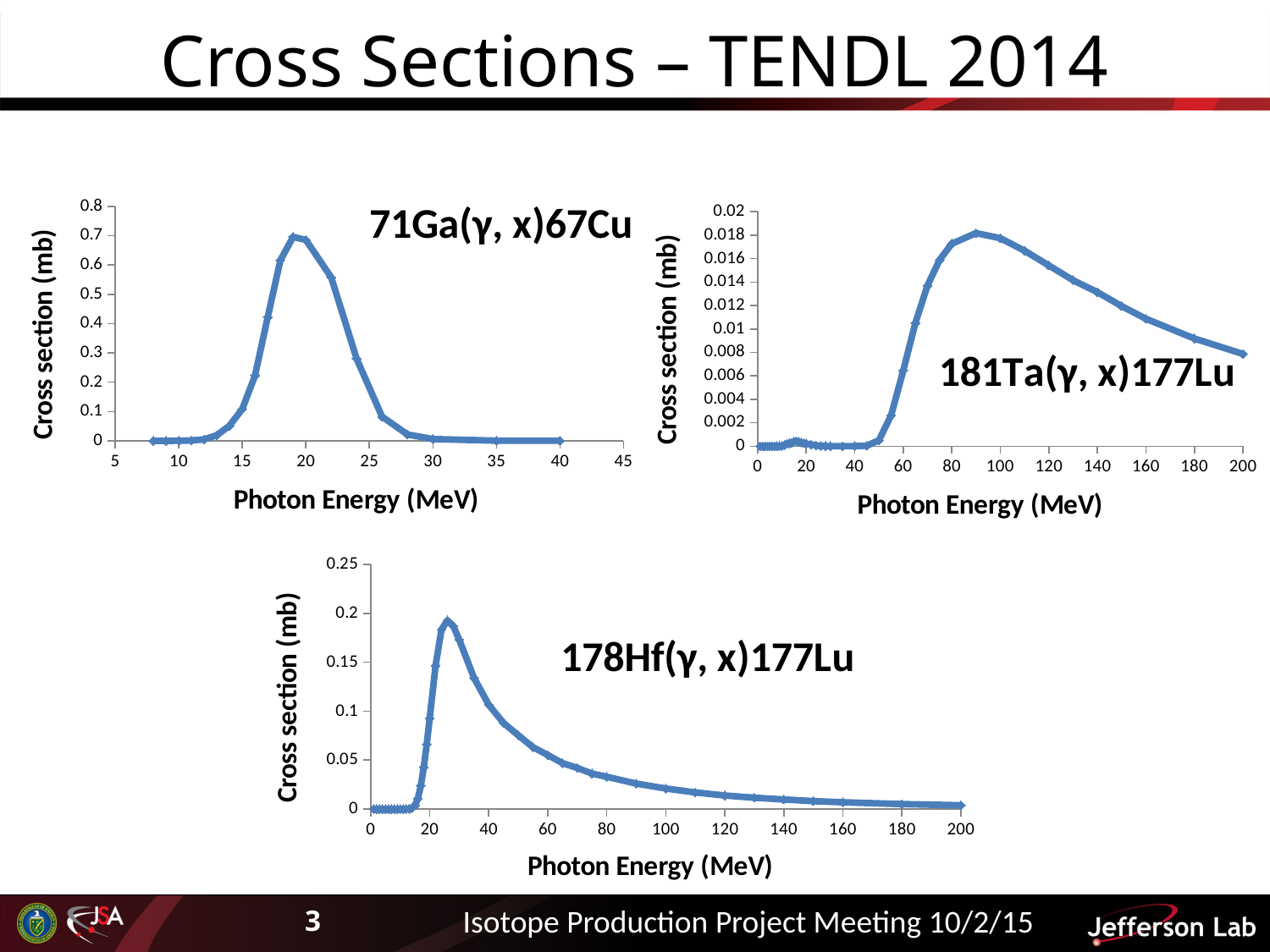
What is the y-axis label of the 181Ta(γ, x)177Lu chart? Cross section (mb) In the 71Ga(γ, x)67Cu chart, is the peak cross section greater or less than 0.6? greater In the 178Hf(γ, x)177Lu chart, does the cross section rise or fall between 40 MeV and 200 MeV? fall In the 181Ta(γ, x)177Lu chart, is the cross section at 200 MeV greater or less than 0.01? less In the 178Hf(γ, x)177Lu chart, is the cross section at 100 MeV greater or less than 0.05? less In the 181Ta(γ, x)177Lu chart, does the cross section rise or fall between 100 MeV and 200 MeV? fall What kind of chart is the 71Ga(γ, x)67Cu chart? line chart What is the x-axis label of the 178Hf(γ, x)177Lu chart? Photon Energy (MeV) How many charts are shown on the slide? 3